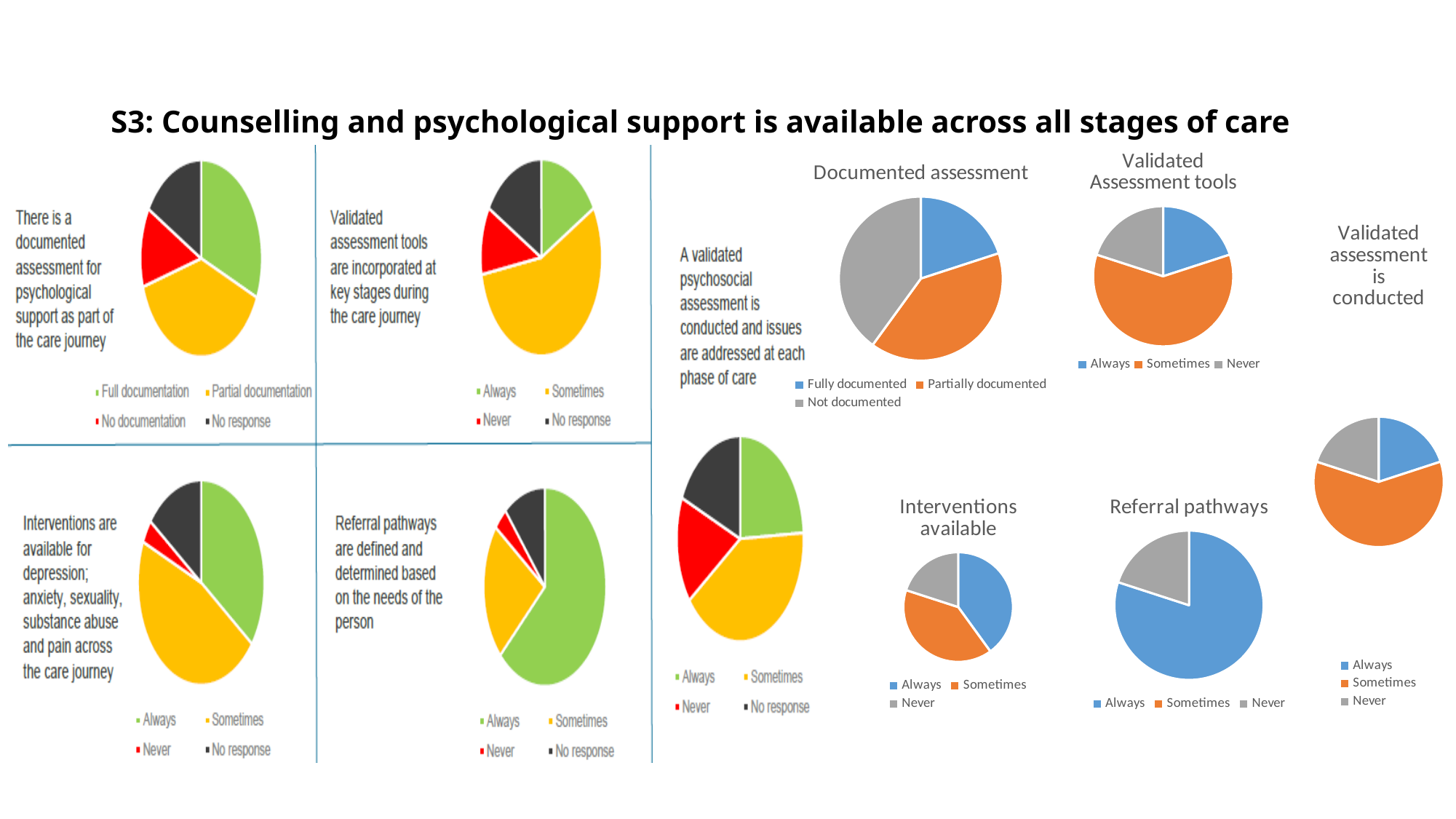
How many categories does the legend of the left-side pie chart "Interventions are available for depression, anxiety, sexuality, substance abuse and pain across the care journey" list? 4 In the left-side pie chart "Referral pathways are defined and determined based on the needs of the person", which category has the largest slice? Always In the "Validated Assessment tools" pie chart on the right, which category has the largest slice? Sometimes How many categories does the legend of the "Documented assessment" pie chart list? 3 What kind of chart is the "Referral pathways" chart on the right side of the slide? pie chart In the left-side pie chart "There is a documented assessment for psychological support as part of the care journey", which category has the largest slice? Partial documentation In the "Documented assessment" pie chart, which category has the smallest slice? Fully documented In the left-side pie chart "Validated assessment tools are incorporated at key stages during the care journey", which category has the smallest slice? Never In the "Interventions available" pie chart on the right, which category has the smallest slice? Never